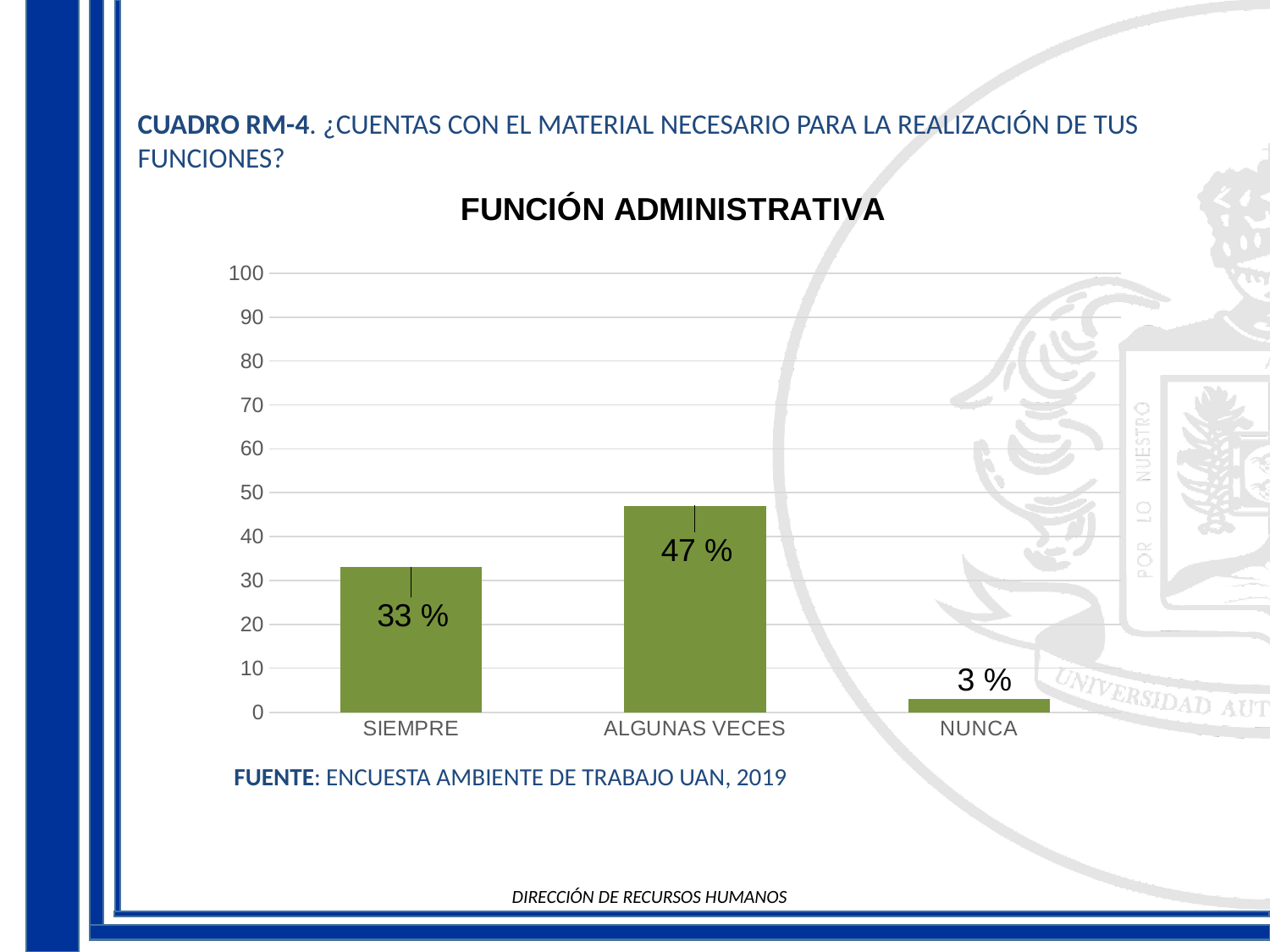
Which category has the lowest value? NUNCA What is the value for SIEMPRE? 33 % What is the difference between the values for ALGUNAS VECES and SIEMPRE? 14 % What is the title of the chart? FUNCIÓN ADMINISTRATIVA Which is larger, the value for SIEMPRE or the value for NUNCA? SIEMPRE What is the value for NUNCA? 3 % What is the difference between the values for SIEMPRE and NUNCA? 30 % Is the value for ALGUNAS VECES greater or less than 50? less How many categories are shown on the x axis? 3 Which category has the highest value? ALGUNAS VECES What kind of chart is shown on the slide? bar chart What is the value for ALGUNAS VECES? 47 %